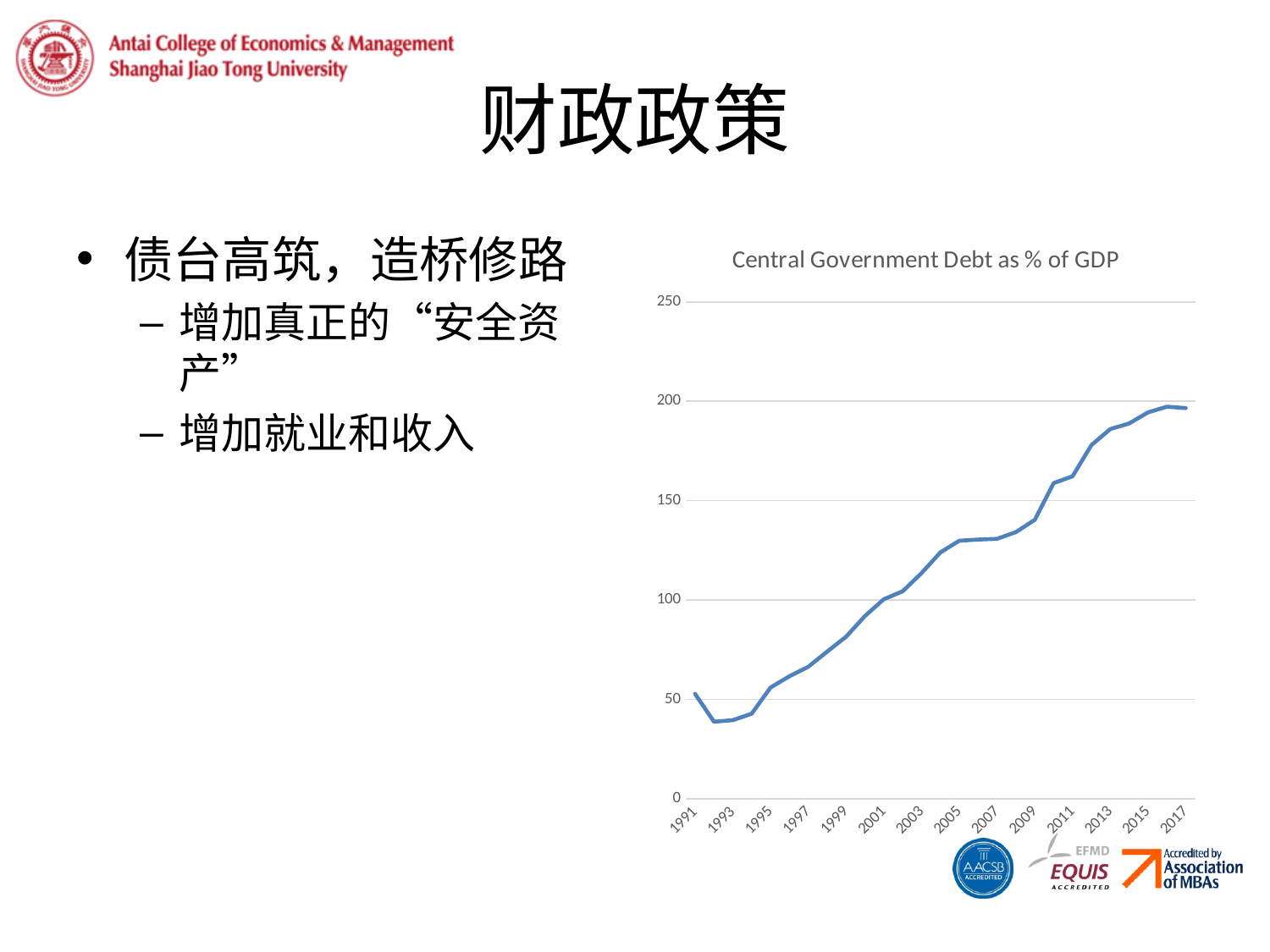
Is the value for 1997 greater or less than 50? greater Is the value for 1993 greater or less than 50? less Is the value for 2013 greater or less than 150? greater Which is larger, the value for 1995 or the value for 2005? 2005 Overall, do the values in the chart rise or fall from 1991 to 2017? rise Which is larger, the value for 2001 or the value for 2011? 2011 What is the highest value shown on the vertical axis? 250 What is the title of the chart? Central Government Debt as % of GDP What kind of chart is shown on the slide? line chart